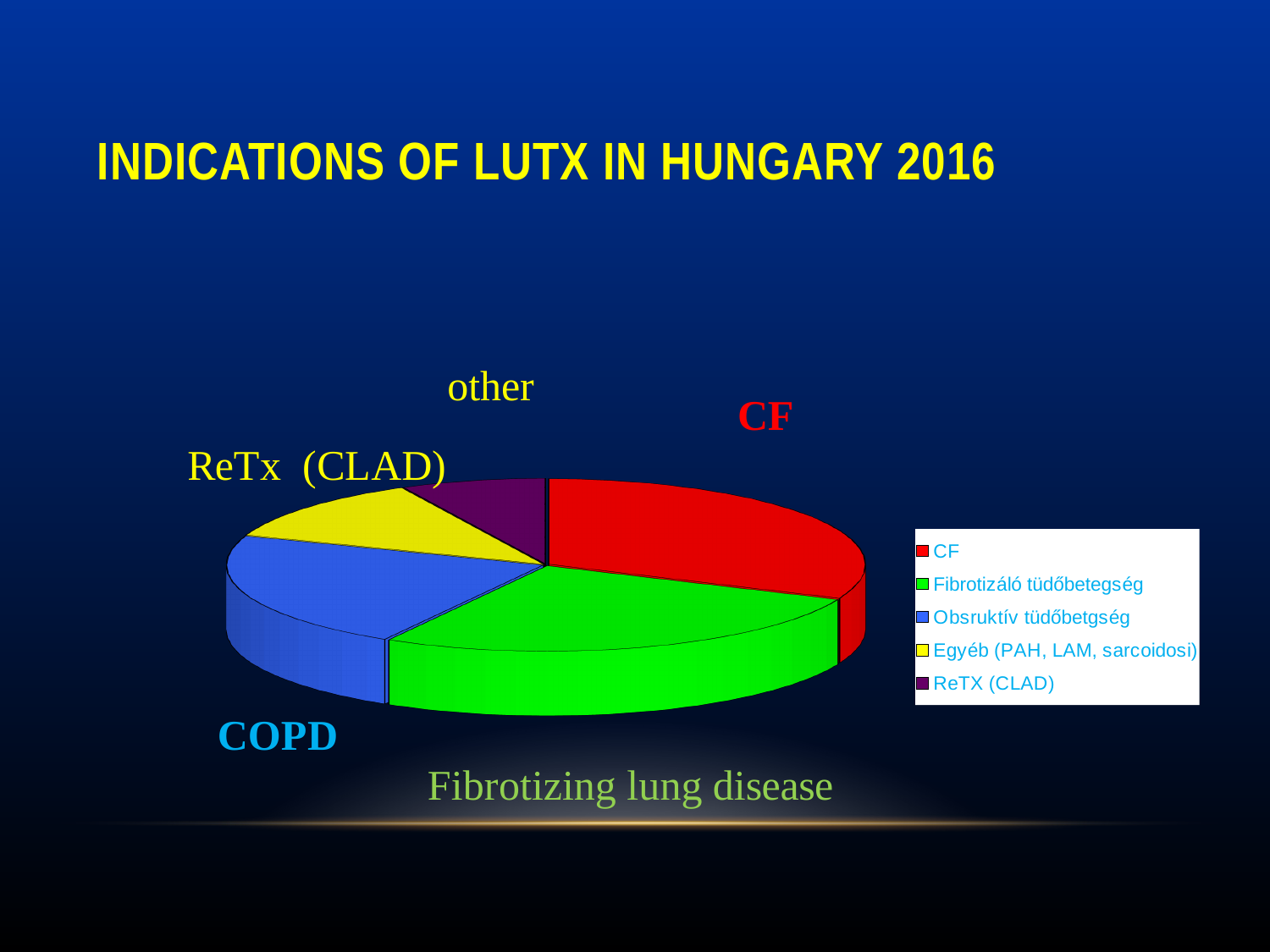
What kind of chart is shown on the slide? pie chart What is the title of the slide containing the pie chart? INDICATIONS OF LUTX IN HUNGARY 2016 Which slice is larger in the pie chart, Fibrotizáló tüdőbetegség or ReTX (CLAD)? Fibrotizáló tüdőbetegség How many slices does the pie chart have? 5 Which category has the smallest slice in the pie chart? ReTX (CLAD) Which slice is larger in the pie chart, Egyéb (PAH, LAM, sarcoidosi) or ReTX (CLAD)? Egyéb (PAH, LAM, sarcoidosi) Which slice is larger in the pie chart, CF or ReTX (CLAD)? CF How many entries does the legend of the pie chart list? 5 What colour is the CF slice in the pie chart? red